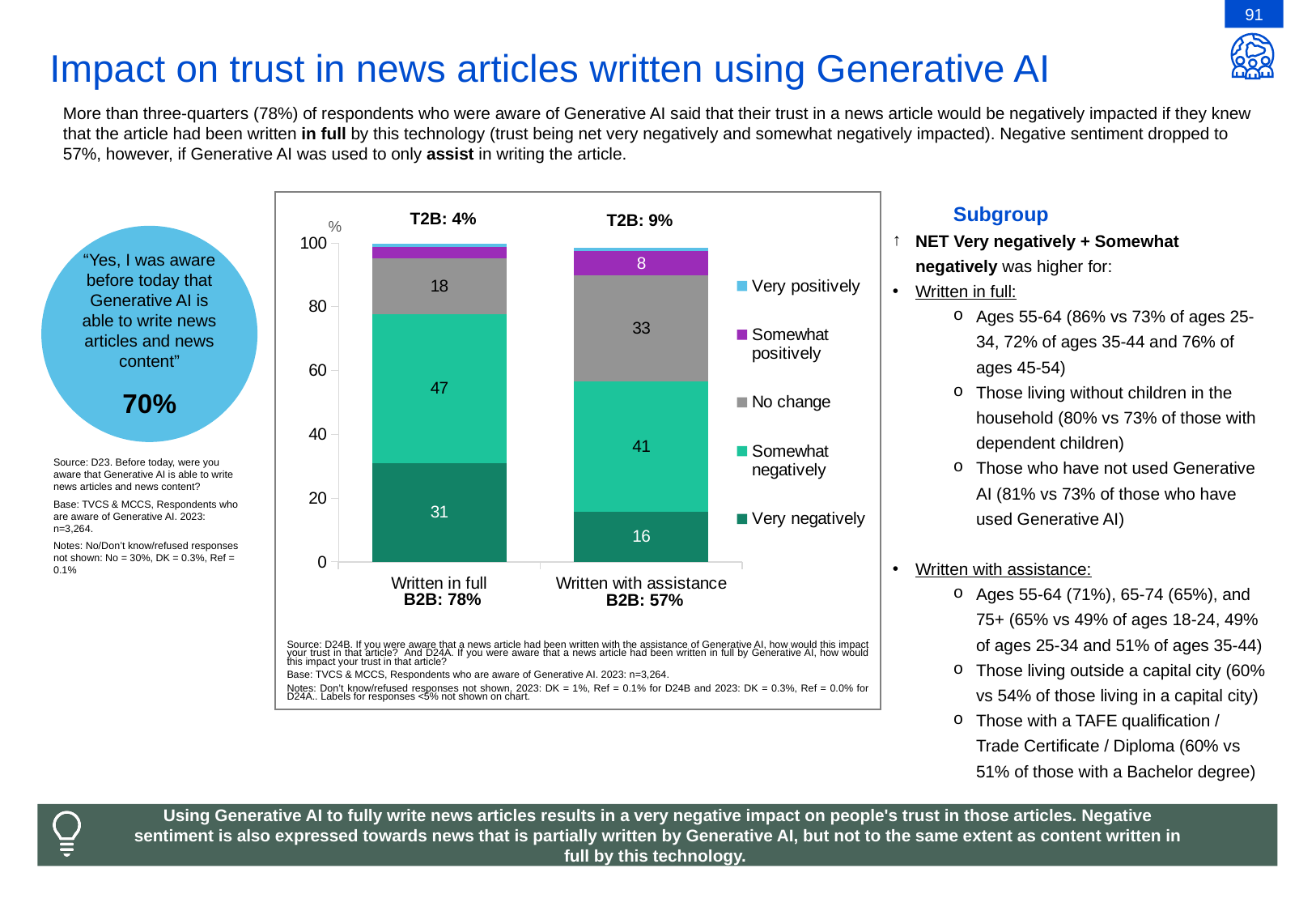
What percentage of respondents said their trust would be very negatively impacted if the article was written in full by Generative AI? 31 Which category has the larger 'No change' value, 'Written in full' or 'Written with assistance'? Written with assistance What is the difference between the 'Very negatively' values for 'Written in full' and 'Written with assistance'? 15 Which response segment is the largest in the 'Written in full' bar? Somewhat negatively What is the 'No change' value for 'Written with assistance'? 33 What is the difference between the 'Somewhat negatively' values for 'Written in full' and 'Written with assistance'? 6 What type of chart is shown on the slide? Stacked bar chart How many categories are shown on the x axis of the chart? 2 How many series does the chart legend list? 5 What B2B value is shown under the 'Written in full' bar? 78% What is the value for 'Somewhat negatively' in the 'Written with assistance' bar? 41 What is the 'Somewhat positively' value shown for 'Written with assistance'? 8